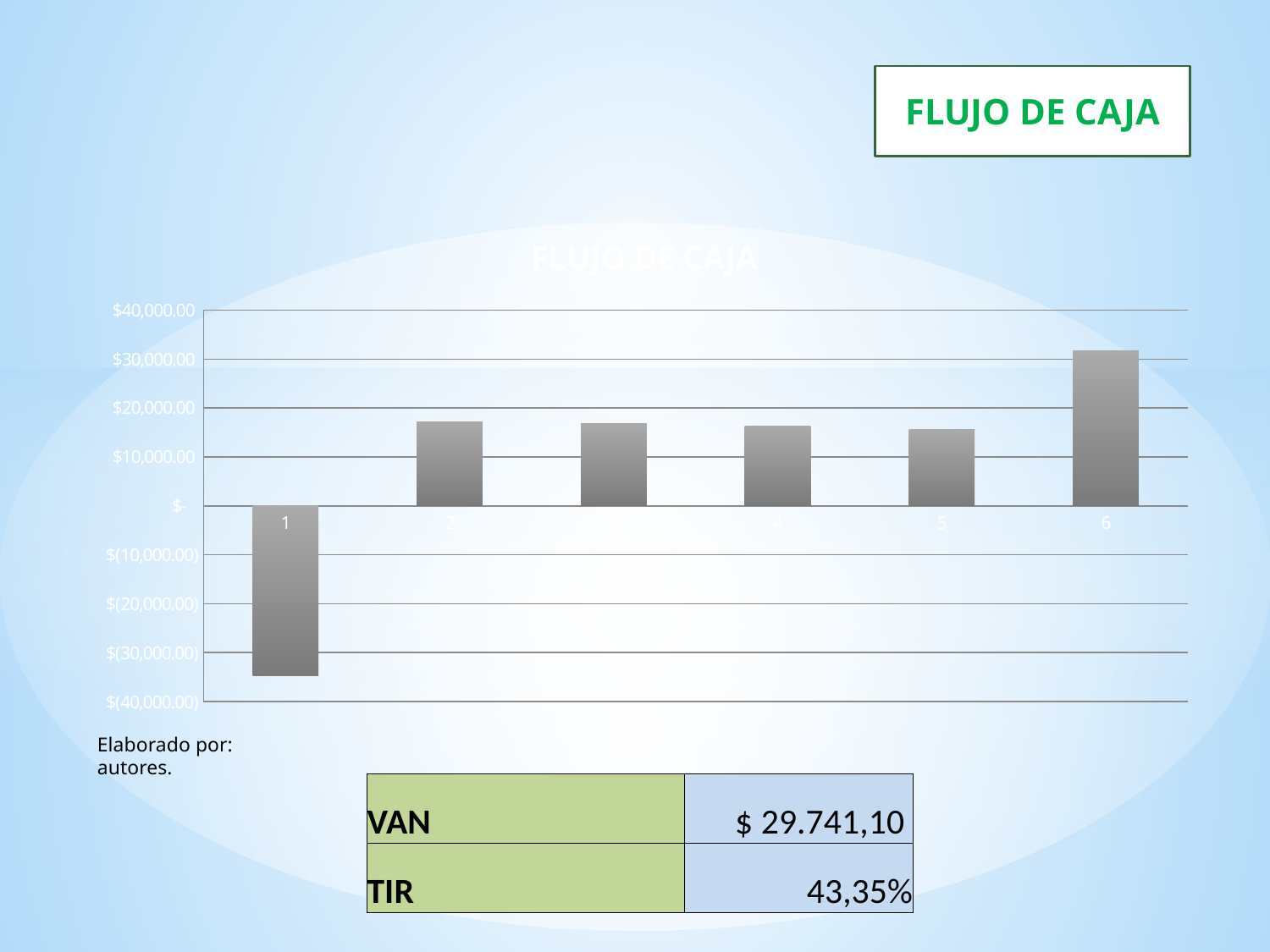
How many bars (categories) does the chart show? 6 Is the value for category 2 greater or less than $10,000.00? greater Is the value for category 5 greater or less than $20,000.00? less Which is larger, the value for category 6 or the value for category 2? 6 Which is larger, the value for category 2 or the value for category 5? 2 Is the value for category 6 greater or less than $30,000.00? greater Which category has the lowest value? 1 Which category has the highest value? 6 How many bars on the chart have a negative value? 1 What kind of chart is shown on the slide? bar chart What is the title of the chart? FLUJO DE CAJA